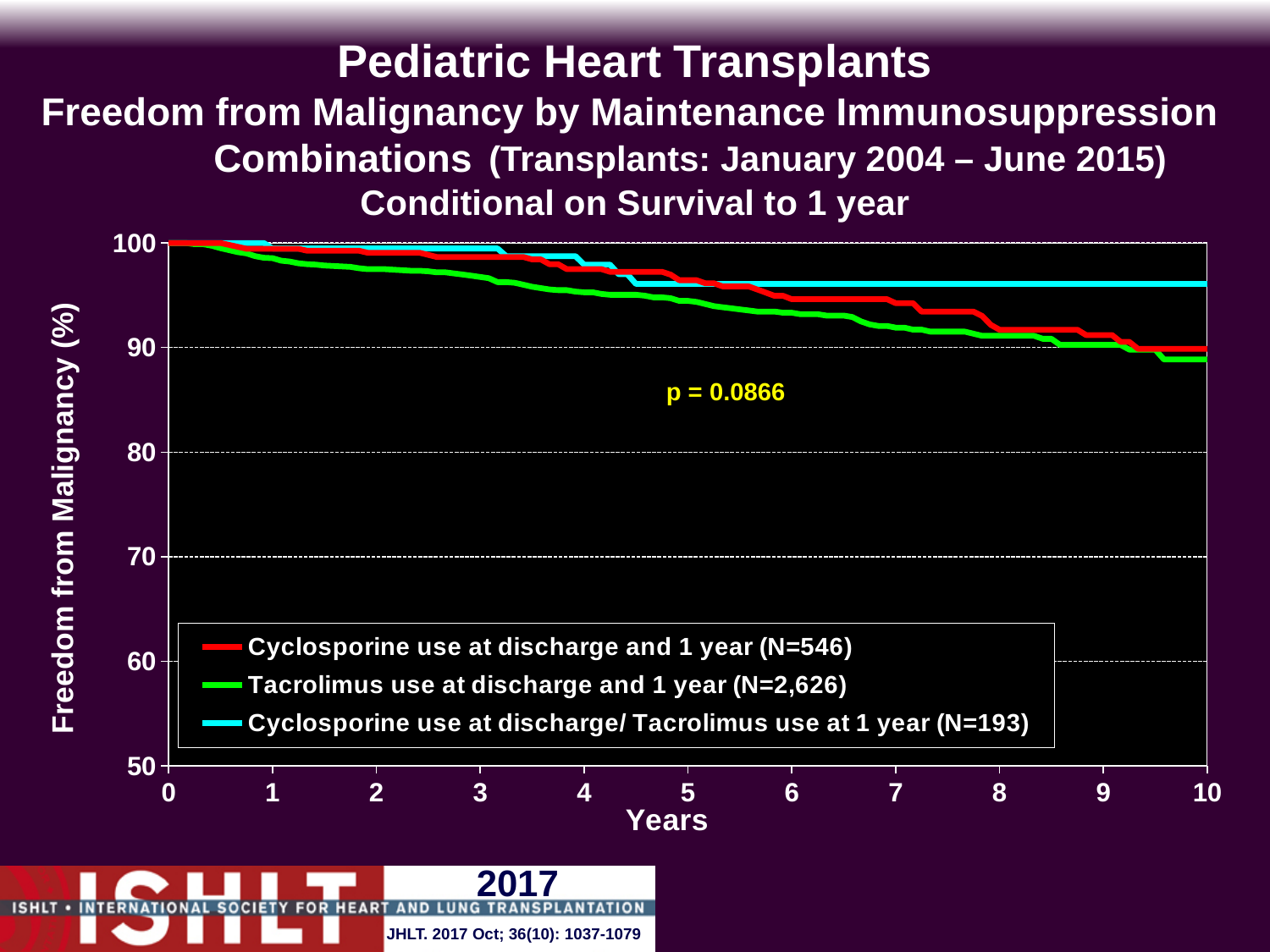
What is the label of the x axis? Years Do the freedom from malignancy curves rise or fall as years increase? fall What is the N for the Tacrolimus use at discharge and 1 year group? N=2,626 How many series does the legend list? 3 Is the freedom from malignancy for the Cyclosporine use at discharge and 1 year group at 5 years greater or less than 90? greater Is the freedom from malignancy for the Tacrolimus use at discharge and 1 year group at 5 years greater or less than 90? greater Which series has the highest freedom from malignancy at 10 years? Cyclosporine use at discharge/ Tacrolimus use at 1 year (N=193) What is the p-value printed on the chart? p = 0.0866 What kind of chart is shown on the slide? line chart Is the freedom from malignancy for the Tacrolimus use at discharge and 1 year group at 10 years greater or less than 90? less At 10 years, which is higher: the Cyclosporine use at discharge/ Tacrolimus use at 1 year group or the Tacrolimus use at discharge and 1 year group? Cyclosporine use at discharge/ Tacrolimus use at 1 year